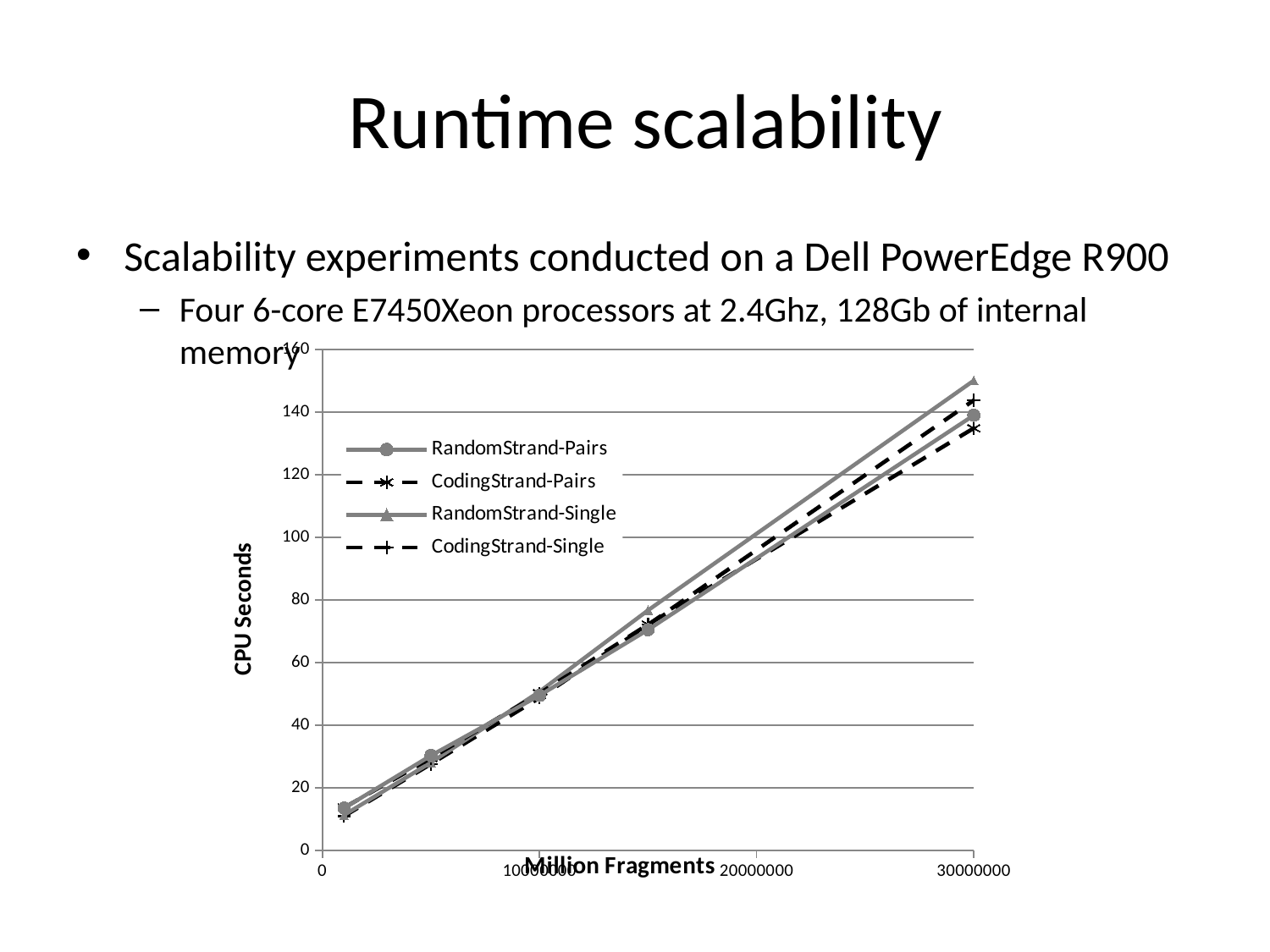
Is the CPU Seconds value for RandomStrand-Pairs at 10000000 fragments greater or less than 40? greater Is the CPU Seconds value for RandomStrand-Pairs at 5000000 fragments greater or less than 20? greater Is the CPU Seconds value for RandomStrand-Single at 30000000 fragments greater or less than 140? greater What kind of chart is shown on the slide? line chart What is the label of the horizontal axis? Million Fragments Which series has the highest CPU Seconds value at 30000000 fragments? RandomStrand-Single At 30000000 fragments, which is larger: the value for RandomStrand-Single or the value for CodingStrand-Pairs? RandomStrand-Single What is the label of the vertical axis? CPU Seconds Do the CPU Seconds values rise or fall as the number of fragments increases? rise How many series does the chart legend list? 4